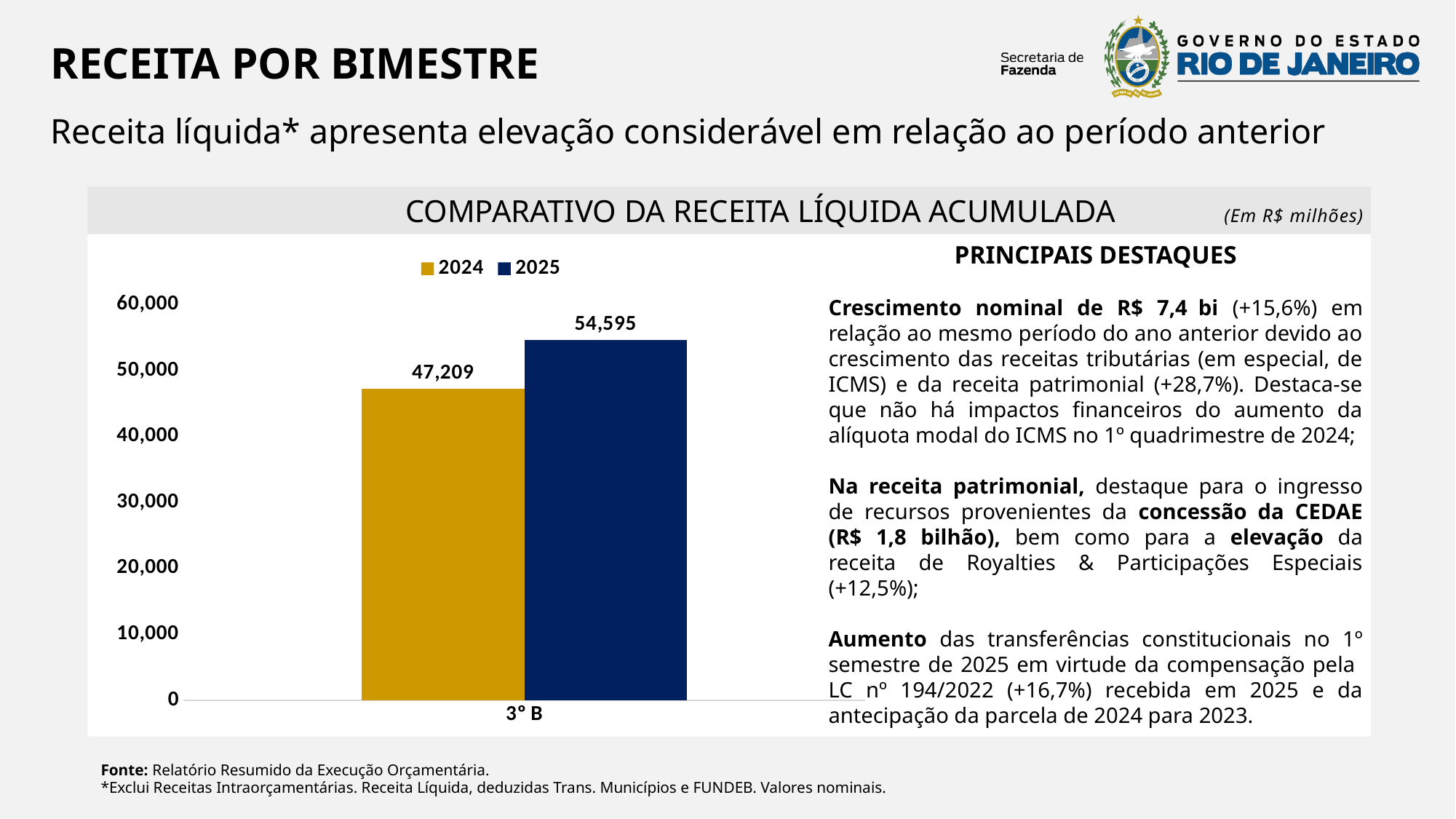
Which colour represents the 2025 series in the chart? dark blue What is the value for 2025 in the 3° B category? 54,595 Is the value for 2025 greater or less than 50,000? greater How many categories are shown on the x axis? 1 How many series does the legend list? 2 What is the label of the category on the x axis? 3° B What kind of chart is shown on the slide? bar chart Which series has the higher value for 3° B, 2024 or 2025? 2025 Is the value for 2024 greater or less than 50,000? less What is the value for 2024 in the 3° B category? 47,209 What is the title of the chart? COMPARATIVO DA RECEITA LÍQUIDA ACUMULADA What is the difference between the 2025 and 2024 values for 3° B? 7,386